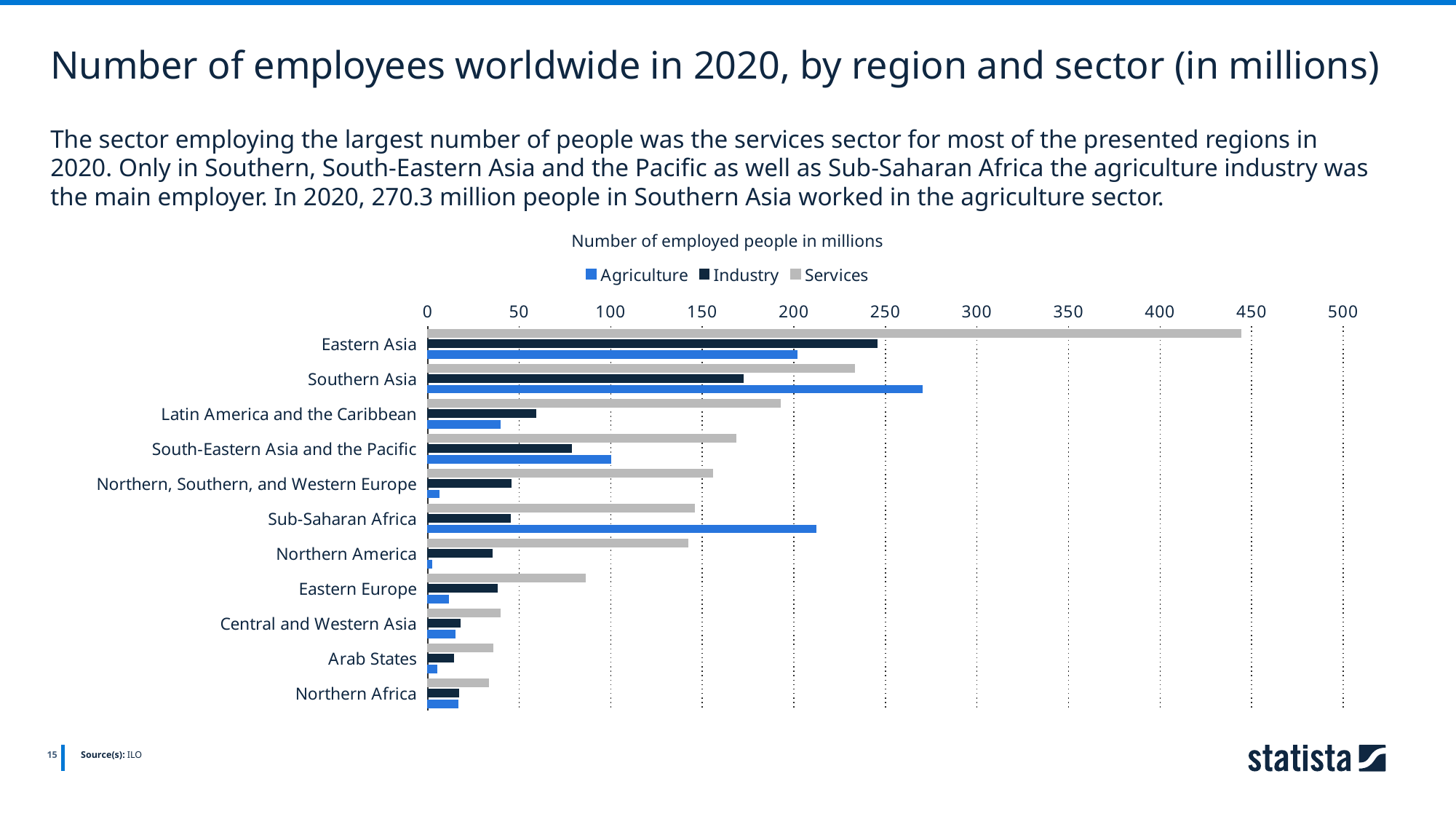
Which region has the largest Agriculture bar? Southern Asia Which region has the smallest Agriculture bar? Northern America Is the Agriculture value for Sub-Saharan Africa greater or less than 200? greater Is the Services value for Eastern Europe greater or less than 100? less How many regions are shown on the chart? 11 Is the Services value for Eastern Asia greater or less than 400? greater Which colour represents the Services series in the legend? Grey What kind of chart is shown on the slide? Bar chart Which region has the largest Services bar? Eastern Asia How many million people in Southern Asia worked in the agriculture sector in 2020, according to the slide text? 270.3 million For Eastern Asia, which is larger: the Industry value or the Agriculture value? Industry How many series does the legend list? 3